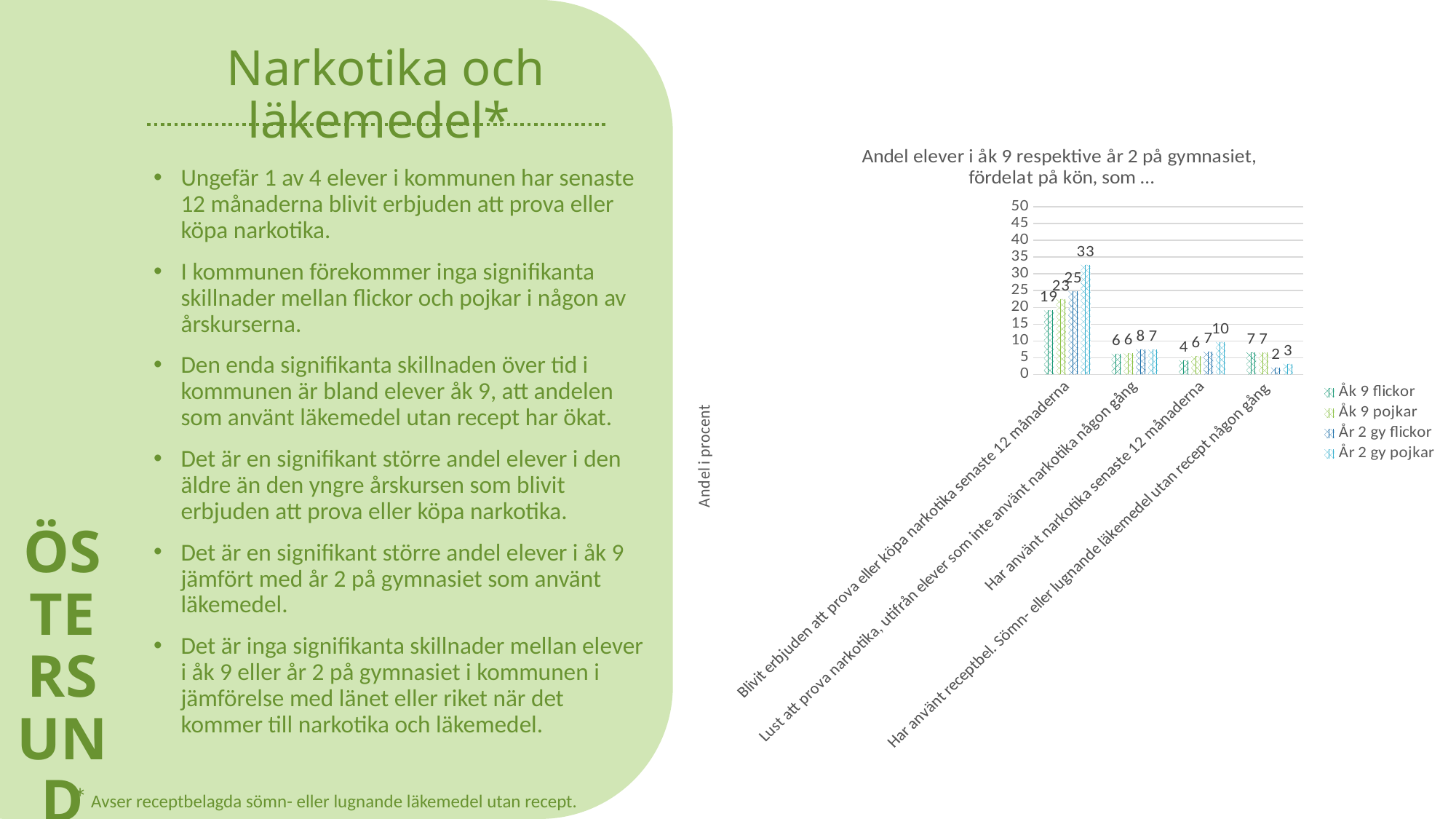
What is the value for År 2 gy pojkar in the category "Blivit erbjuden att prova eller köpa narkotika senaste 12 månaderna"? 33 What type of chart is shown on the slide? Bar chart What is the value for År 2 gy flickor in the category "Har använt receptbel. Sömn- eller lugnande läkemedel utan recept någon gång"? 2 What is the value for Åk 9 flickor in the category "Blivit erbjuden att prova eller köpa narkotika senaste 12 månaderna"? 19 What is the difference between År 2 gy pojkar and Åk 9 flickor in the category "Blivit erbjuden att prova eller köpa narkotika senaste 12 månaderna"? 14 Is the value for År 2 gy pojkar in the category "Blivit erbjuden att prova eller köpa narkotika senaste 12 månaderna" greater or less than 30? greater How many categories are shown on the x axis of the chart? 4 What is the value for År 2 gy pojkar in the category "Har använt narkotika senaste 12 månaderna"? 10 Which series has the lowest value in the category "Har använt narkotika senaste 12 månaderna"? Åk 9 flickor Which series has the highest value in the category "Blivit erbjuden att prova eller köpa narkotika senaste 12 månaderna"? År 2 gy pojkar How many series does the chart legend list? 4 In the category "Har använt receptbel. Sömn- eller lugnande läkemedel utan recept någon gång", which is larger: Åk 9 pojkar or År 2 gy pojkar? Åk 9 pojkar